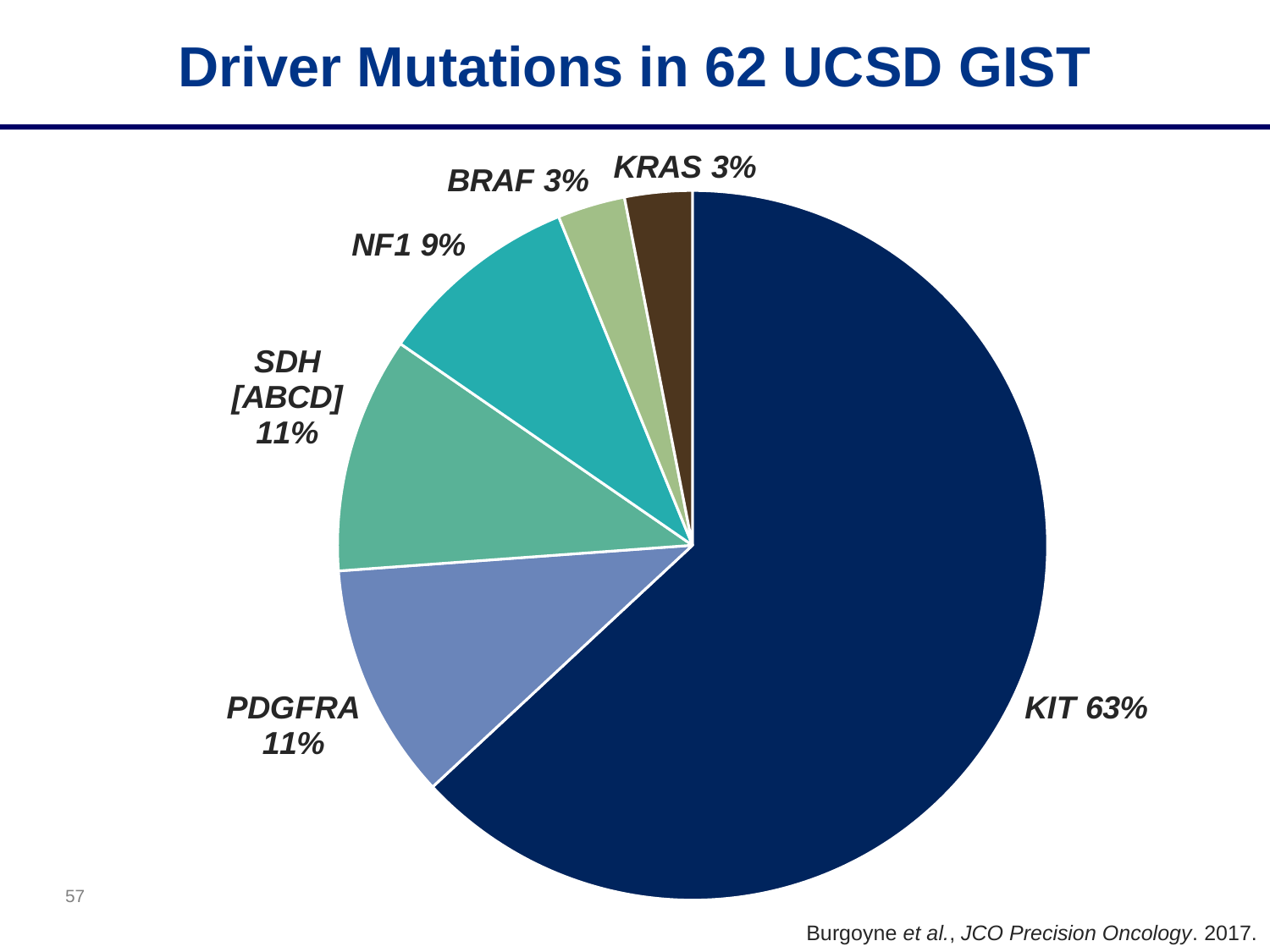
What is the difference in percentage points between SDH [ABCD] and NF1? 2 How many slices does the pie chart have? 6 What percentage of the pie is NF1? 9% What is the title of the chart? Driver Mutations in 62 UCSD GIST What colour is the KIT slice? dark navy blue Which is larger, the share for NF1 or the share for KRAS? NF1 What percentage of the pie is KIT? 63% What percentage of the pie is SDH [ABCD]? 11% Which driver mutation has the largest share of the pie? KIT What is the difference in percentage points between KIT and PDGFRA? 52 What kind of chart is shown on the slide? pie chart What percentage of the pie is BRAF? 3%